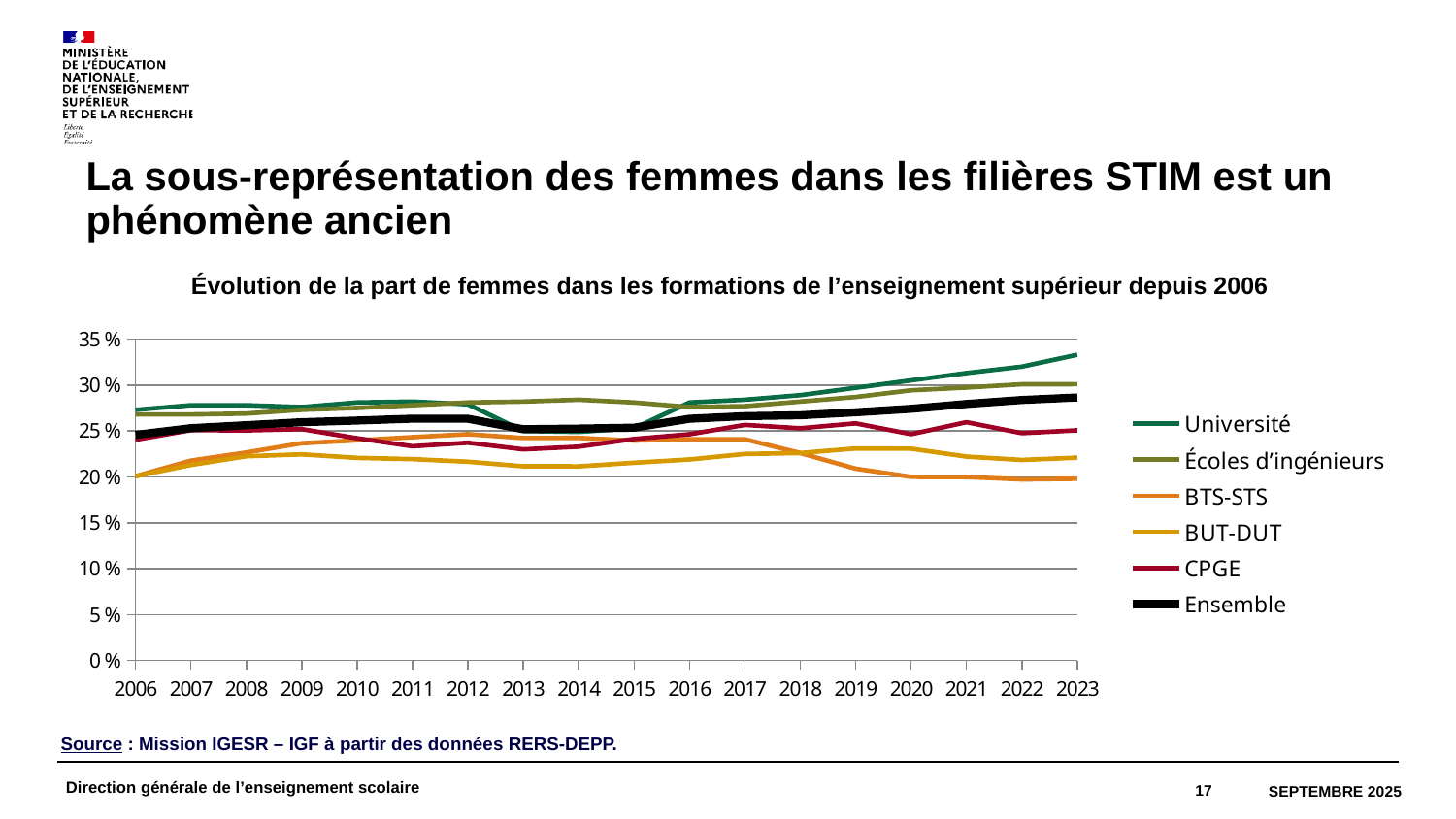
How many years are shown along the x axis? 18 Which series has the highest value in 2023? Université How many series does the legend list? 6 Is the value for Université in 2023 greater or less than 30%? greater In 2023, which is larger: the value for Université or the value for CPGE? Université Is the value for Ensemble in 2023 greater or less than 25%? greater Is the value for CPGE in 2006 greater or less than 25%? less Which series has the lowest value in 2023? BTS-STS Which series is drawn with the thick black line? Ensemble Does the Université series rise or fall overall from 2006 to 2023? Rise Does the BTS-STS series rise or fall from 2017 to 2023? Fall What kind of chart is shown on the slide? Line chart